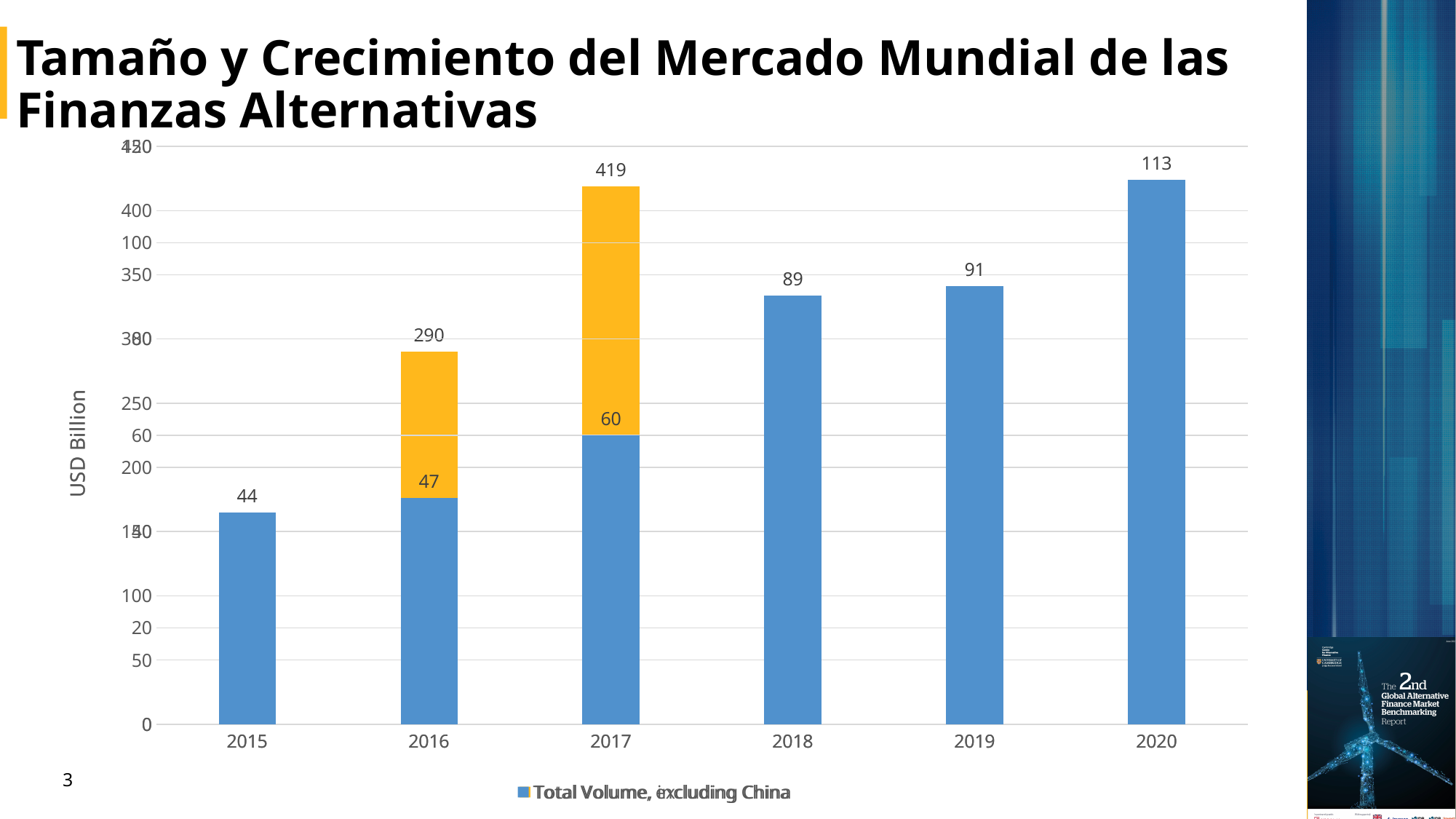
What value is printed at the top of the 2017 bar? 419 What is the difference between the blue bar values for 2020 and 2015? 69 Which is larger, the blue bar value for 2019 or for 2018? 2019 Do the blue bar values rise or fall from 2015 to 2020? rise Which year has the highest blue bar value? 2020 Which year has the lowest blue bar value? 2015 What is the value of the blue bar for 2015? 44 What is the value of the blue bar for 2018? 89 What value is printed at the top of the 2016 bar? 290 How many years are shown on the x axis? 6 What is the difference between the blue bar values for 2017 and 2016? 13 What is the value of the blue bar for 2020? 113